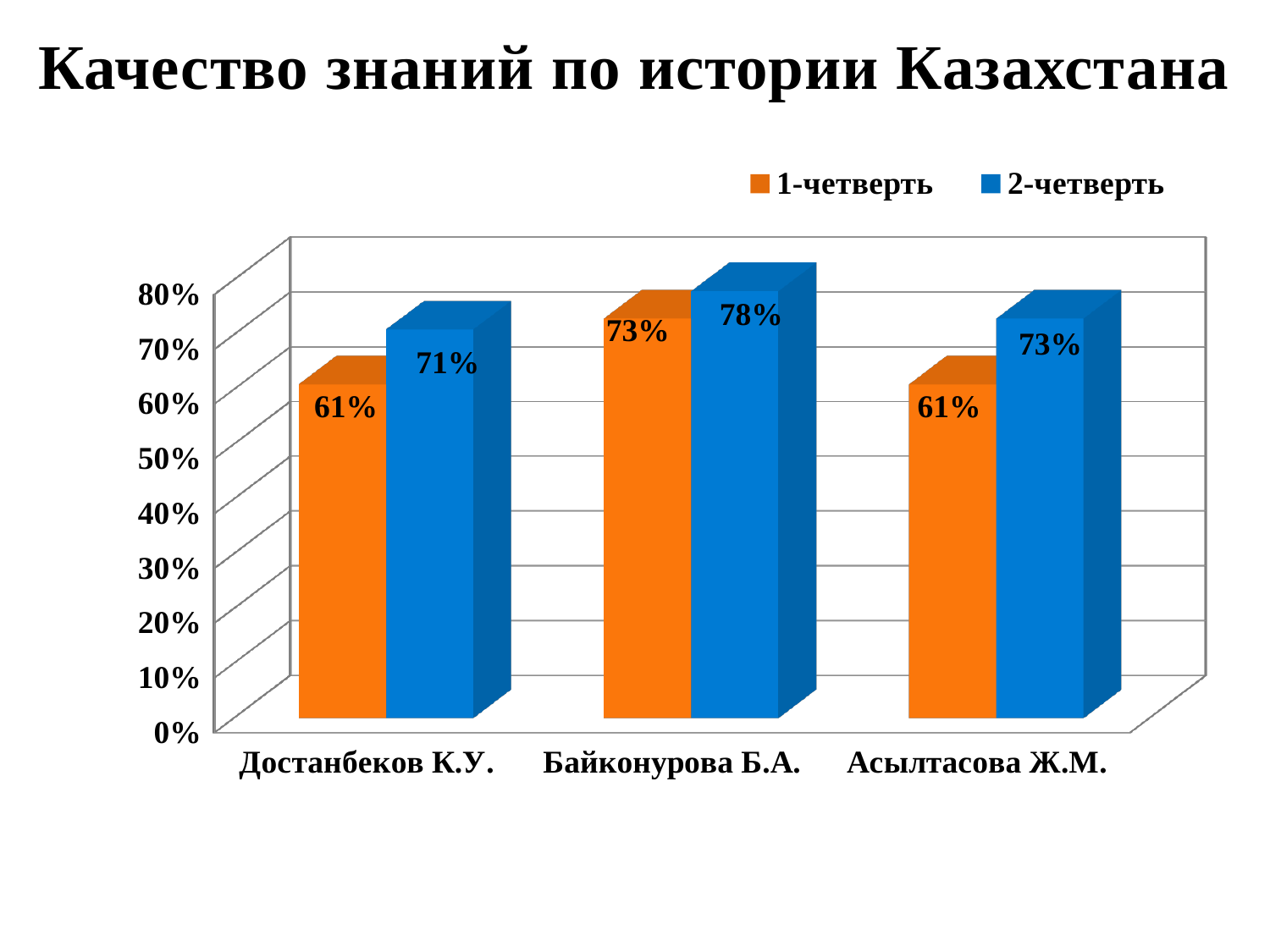
Which category has the highest value in the 2-четверть series? Байконурова Б.А. What kind of chart is shown on the slide? Bar chart What is the difference between the 2-четверть and 1-четверть values for Достанбеков К.У.? 10% How many series does the legend list? 2 What is the value for Байконурова Б.А. in the 2-четверть series? 78% What is the value for Асылтасова Ж.М. in the 2-четверть series? 73% How many categories are shown on the x axis? 3 Which category has the highest value in the 1-четверть series? Байконурова Б.А. What is the difference between the 2-четверть and 1-четверть values for Асылтасова Ж.М.? 12% Which is larger: the 1-четверть value for Байконурова Б.А. or the 1-четверть value for Асылтасова Ж.М.? Байконурова Б.А. What is the value for Достанбеков К.У. in the 1-четверть series? 61% What is the title of the chart? Качество знаний по истории Казахстана